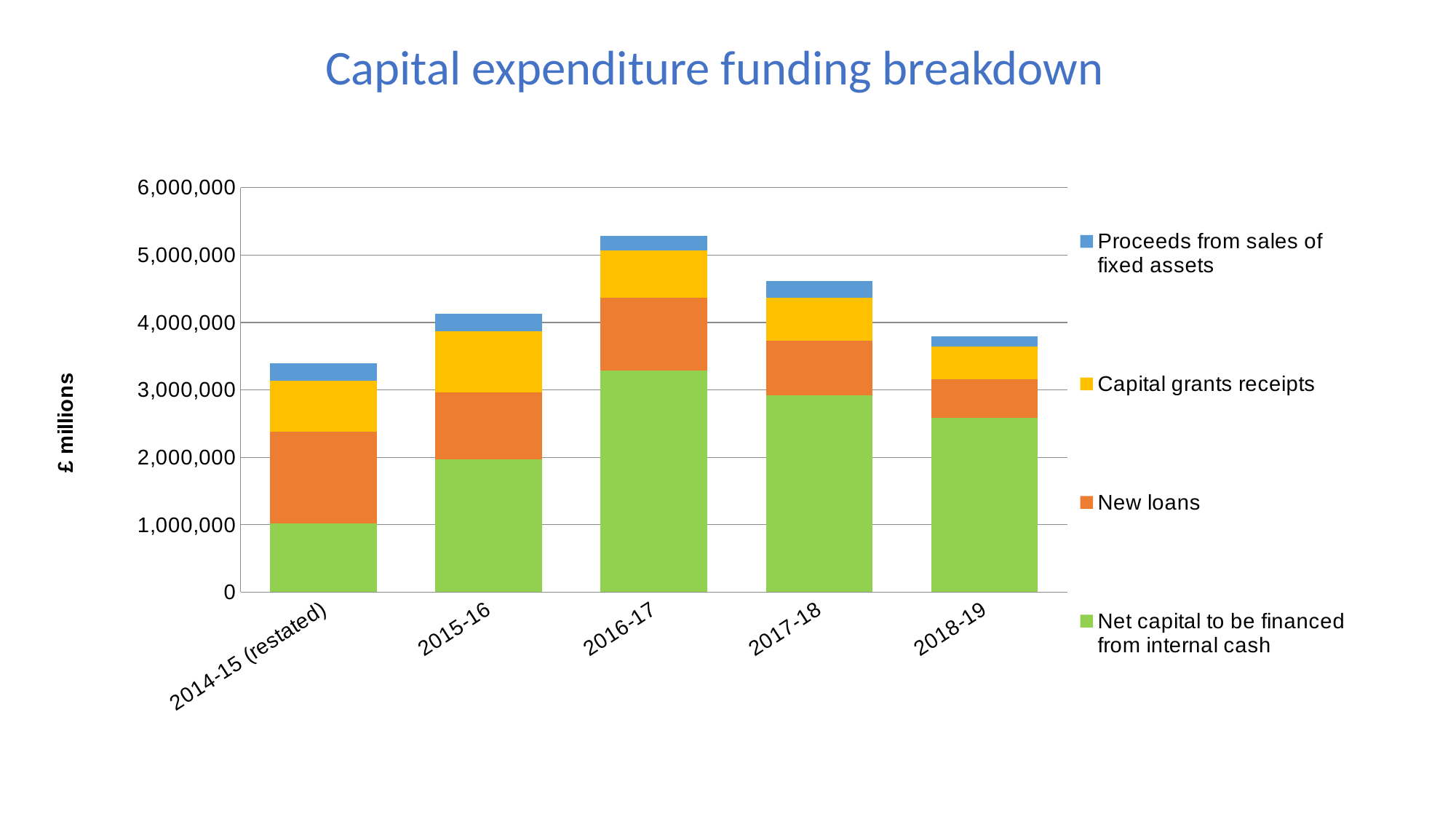
How many series does the legend list? 4 How many years (categories) are shown on the x axis? 5 Is the total bar for 2014-15 (restated) greater or less than 4,000,000? less What is the title of the chart? Capital expenditure funding breakdown Which year has a larger total bar, 2015-16 or 2018-19? 2015-16 Is the 'Net capital to be financed from internal cash' segment for 2016-17 greater or less than 3,000,000? greater Which year has the tallest total bar? 2016-17 Which year has a larger 'Net capital to be financed from internal cash' segment, 2017-18 or 2018-19? 2017-18 Which year has the shortest total bar? 2014-15 (restated) Is the total bar for 2016-17 greater or less than 5,000,000? greater Do the total bar heights rise or fall from 2016-17 to 2018-19? fall What kind of chart is shown on the slide? Stacked bar chart